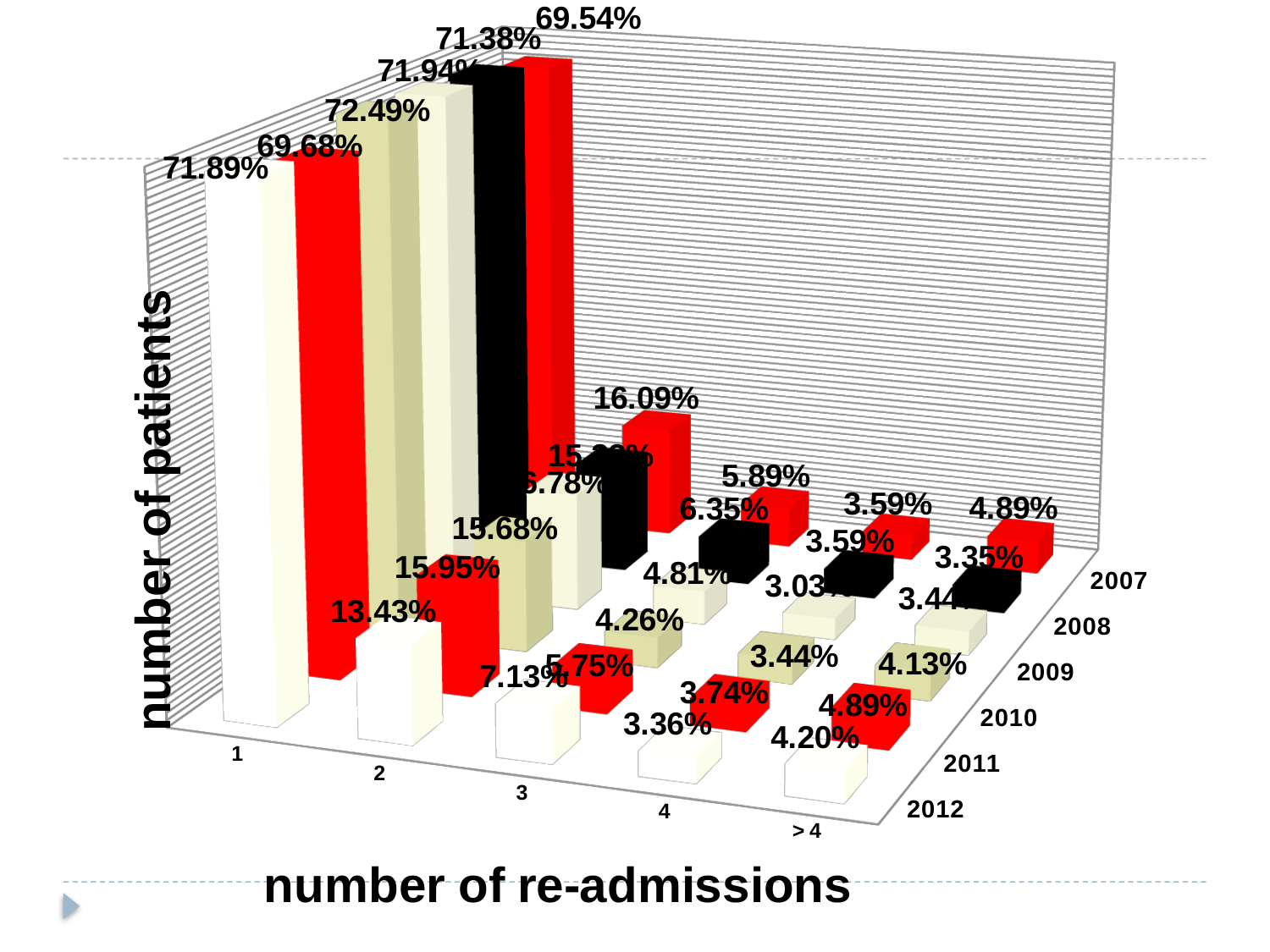
What is the value for 1 re-admission in 2012? 71.89% What is the value for 3 re-admissions in 2012? 7.13% What is the value for 2 re-admissions in 2011? 15.95% What kind of chart is shown on the slide? bar chart How many years are plotted in the chart? 6 How many categories are shown on the 'number of re-admissions' axis? 5 What is the title of the horizontal axis? number of re-admissions What is the value for 1 re-admission in 2010? 72.49% For 2012, which number of re-admissions has the highest value? 1 For 2012, which is larger: the value for 4 re-admissions or for > 4 re-admissions? > 4 What is the value for 2 re-admissions in 2007? 16.09% What is the value for 2 re-admissions in 2012? 13.43%